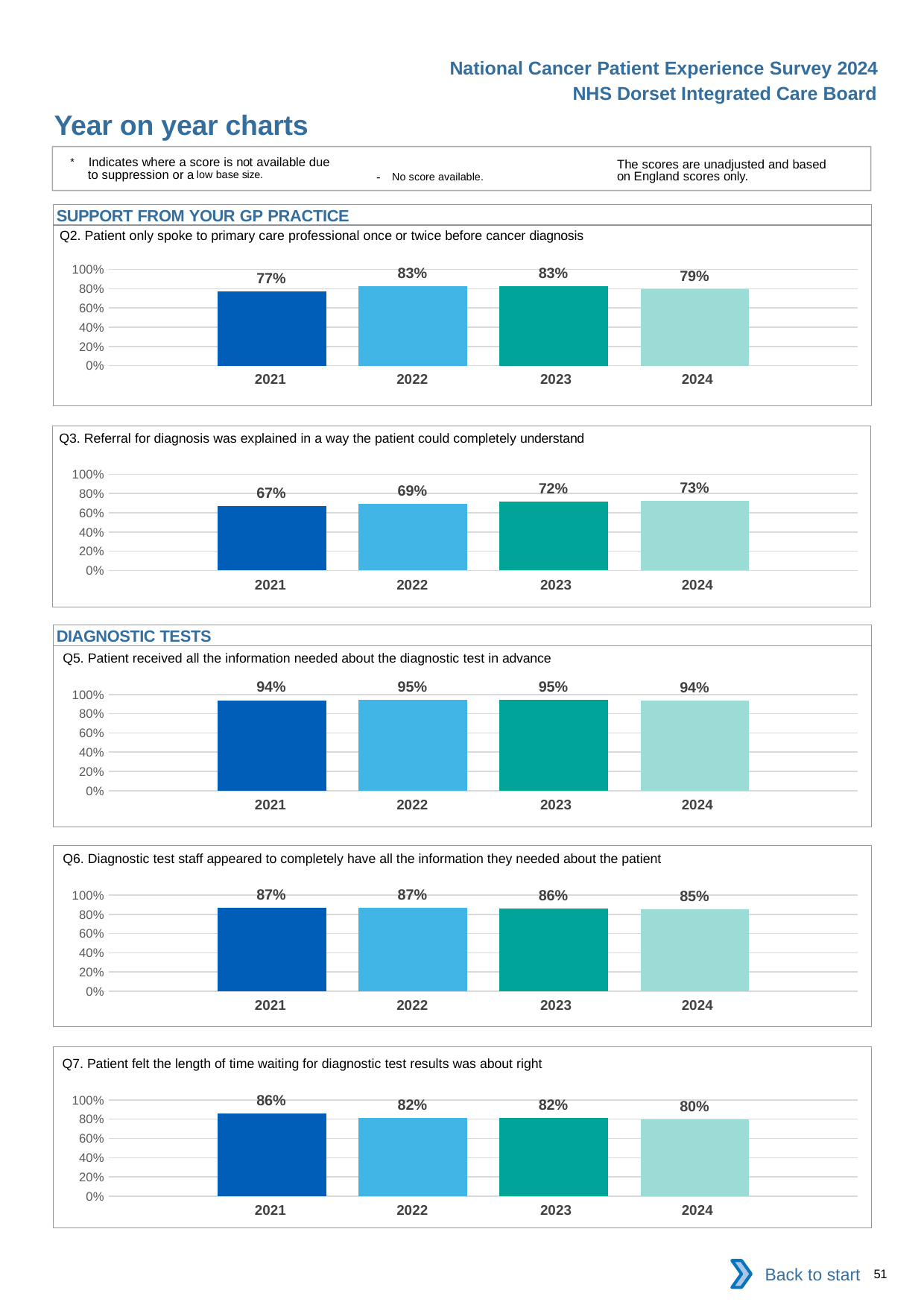
In the Q2 chart (patient only spoke to primary care professional once or twice before cancer diagnosis), what is the value for 2021? 77% How many years are shown in the Q5 chart (patient received all the information needed about the diagnostic test in advance)? 4 In the Q2 chart (patient only spoke to primary care professional once or twice before cancer diagnosis), which is larger, the value for 2022 or the value for 2024? 2022 Which section heading appears above the Q5 chart? DIAGNOSTIC TESTS In the Q7 chart (patient felt the length of time waiting for diagnostic test results was about right), what is the difference between the 2021 and 2024 values? 6 percentage points In the Q5 chart (patient received all the information needed about the diagnostic test in advance), what is the value for 2023? 95% In the Q7 chart (patient felt the length of time waiting for diagnostic test results was about right), which year has the highest value? 2021 In the Q3 chart (referral for diagnosis was explained in a way the patient could completely understand), which year has the highest value? 2024 What kind of chart is the Q6 chart (diagnostic test staff appeared to completely have all the information they needed about the patient)? bar chart In the Q3 chart (referral for diagnosis was explained in a way the patient could completely understand), what is the difference between the 2024 and 2021 values? 6 percentage points In the Q6 chart (diagnostic test staff appeared to completely have all the information they needed about the patient), which year has the lowest value? 2024 In the Q7 chart (patient felt the length of time waiting for diagnostic test results was about right), do the values rise or fall from 2021 to 2024? fall